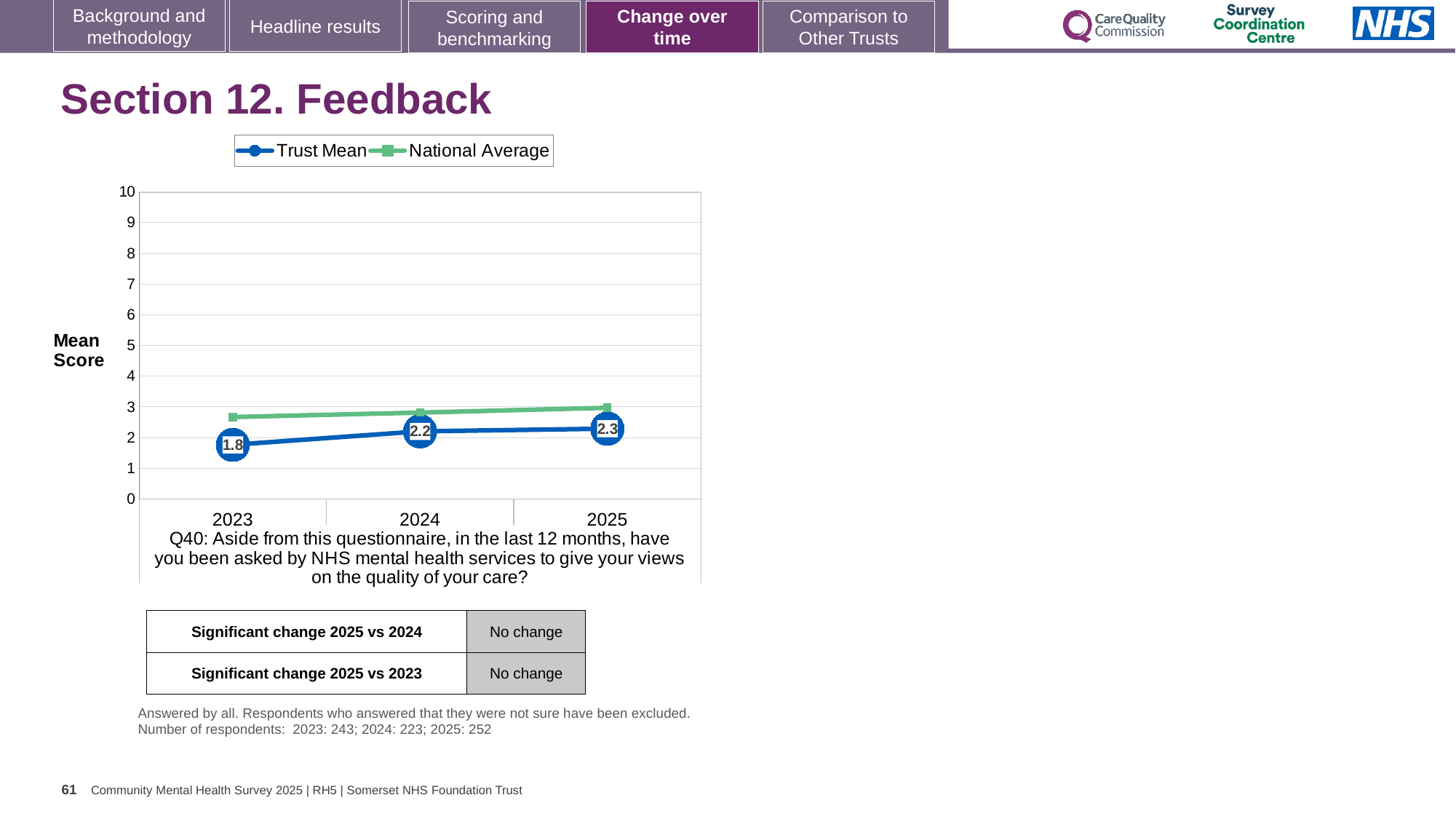
How many years are plotted on the x axis? 3 Does the Trust Mean score rise or fall from 2023 to 2025? Rise How many series does the legend list? 2 By how much did the Trust Mean score change from 2023 to 2025? 0.5 Is the National Average value for 2023 greater or less than 2? greater What is the Trust Mean score for 2024? 2.2 In which year is the Trust Mean score lowest? 2023 In 2023, which is higher: the Trust Mean or the National Average? National Average What is the Trust Mean score for 2023? 1.8 What kind of chart is shown on the slide? Line chart What is the Trust Mean score for 2025? 2.3 In which year is the Trust Mean score highest? 2025